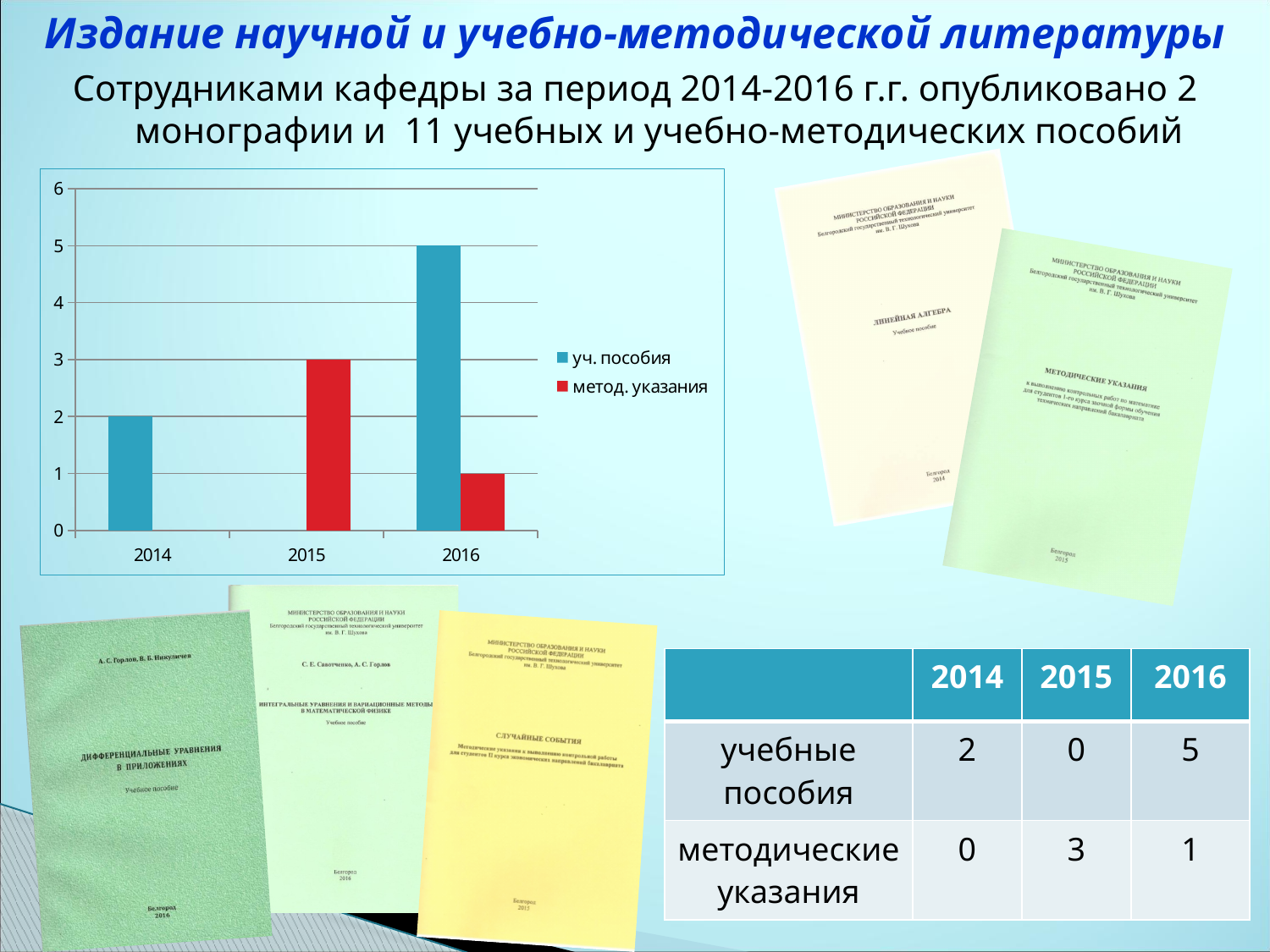
What is the difference between уч. пособия and метод. указания in 2016? 4 In which year is the value for уч. пособия highest? 2016 Which colour represents метод. указания in the chart? red What is the value for метод. указания in 2016? 1 What is the value for метод. указания in 2015? 3 Which is larger in 2016, уч. пособия or метод. указания? уч. пособия How many years are shown on the x axis of the chart? 3 What is the value for уч. пособия in 2016? 5 In which year is the value for метод. указания highest? 2015 How many series does the chart legend list? 2 What is the value for уч. пособия in 2014? 2 What kind of chart is shown on the slide? bar chart